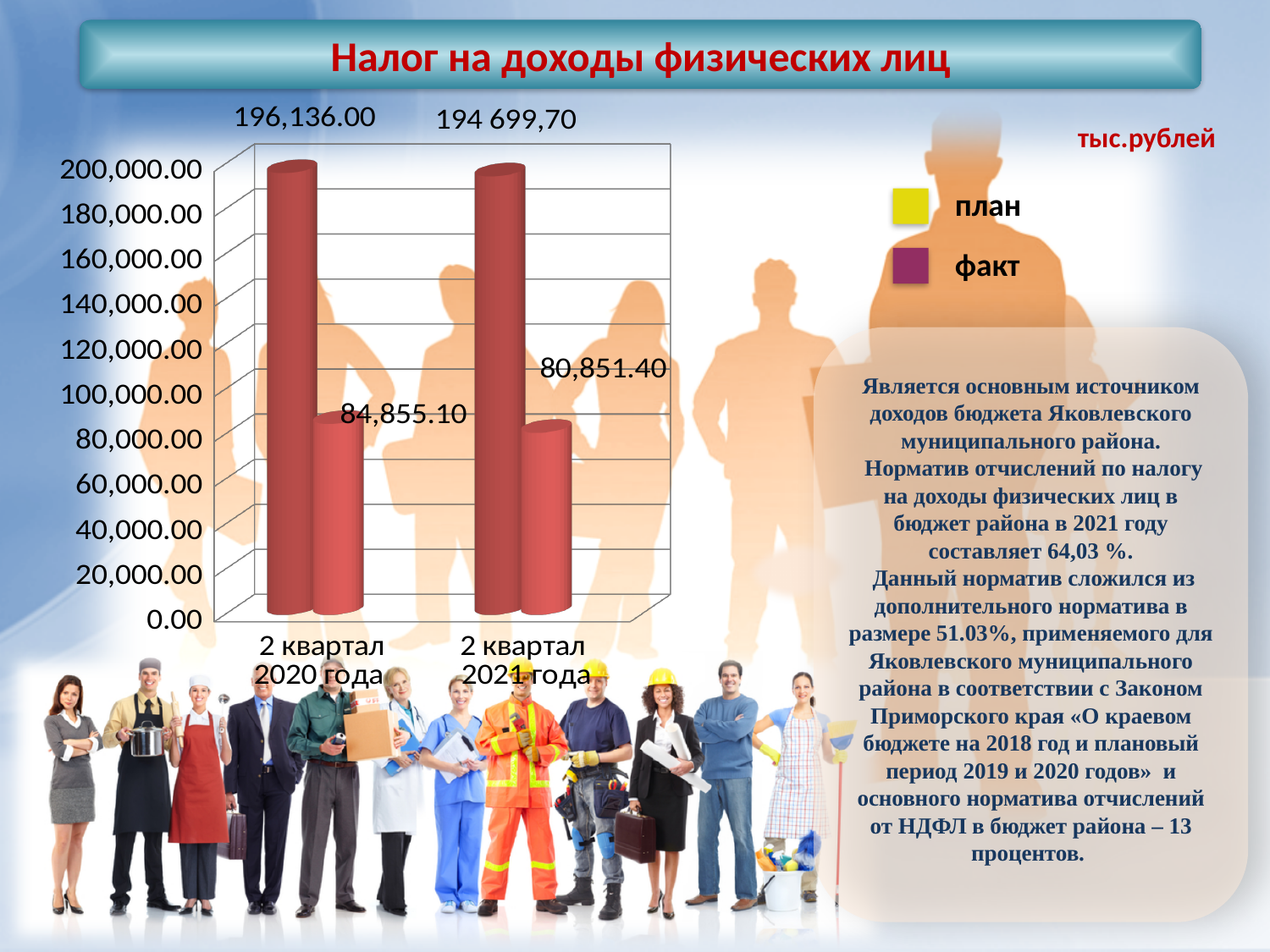
Which category has the higher факт value, 2 квартал 2020 года or 2 квартал 2021 года? 2 квартал 2020 года What is the план value for 2 квартал 2021 года? 194 699,70 What is the difference between the факт values for 2 квартал 2020 года and 2 квартал 2021 года? 4,003.70 Is the факт value for 2 квартал 2021 года greater or less than 100,000.00? less What is the план value for 2 квартал 2020 года? 196,136.00 What is the факт value for 2 квартал 2020 года? 84,855.10 How many categories are shown on the x axis? 2 What are the two series named in the legend? план and факт What is the title of the chart? Налог на доходы физических лиц What type of chart is shown on the slide? bar chart What is the факт value for 2 квартал 2021 года? 80,851.40 How many series does the legend list? 2